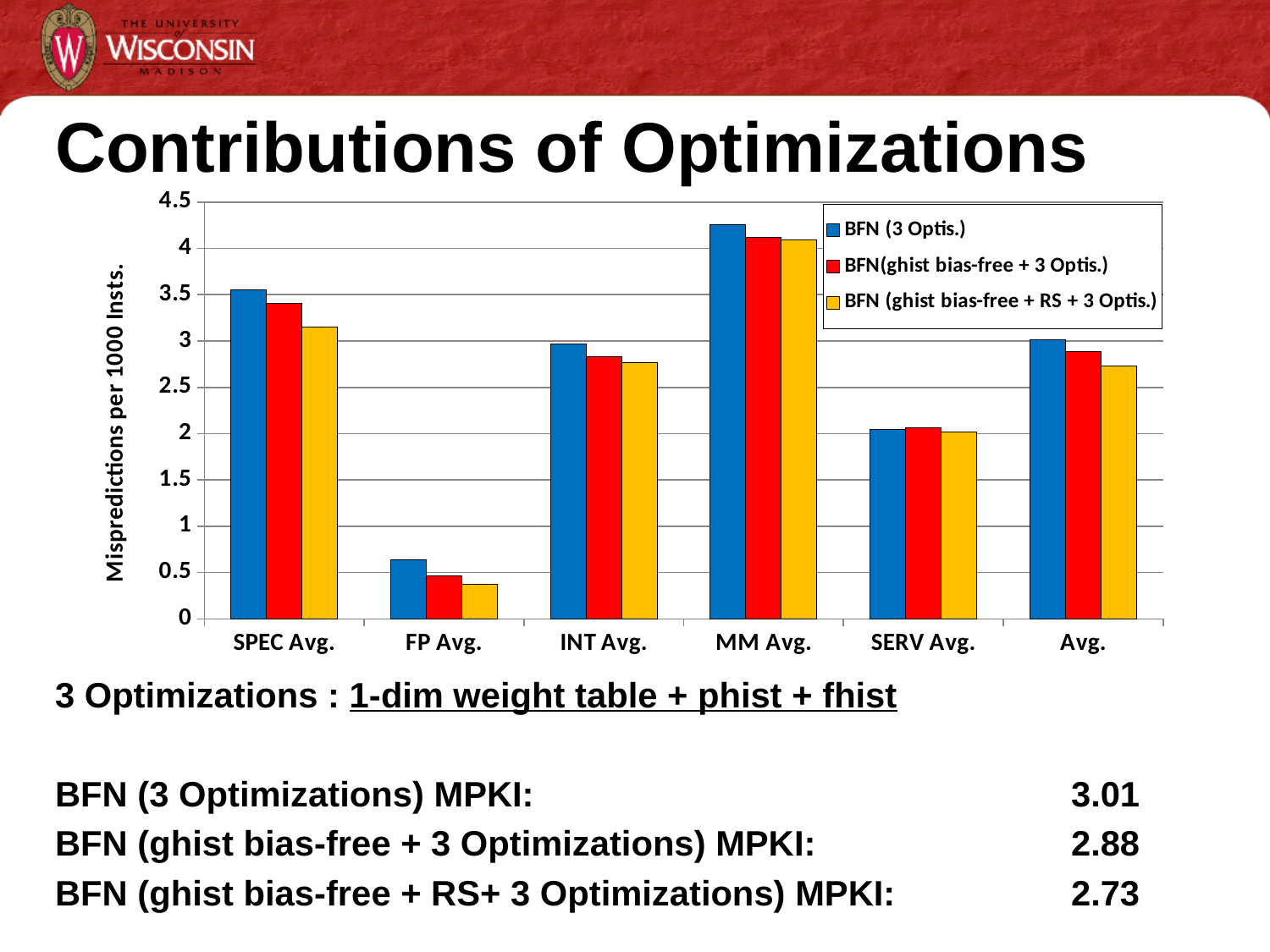
How many series does the chart's legend list? 3 According to the slide, what is the MPKI for BFN (ghist bias-free + RS + 3 Optimizations)? 2.73 For SPEC Avg., which series has the larger value: BFN (3 Optis.) or BFN (ghist bias-free + RS + 3 Optis.)? BFN (3 Optis.) Is the BFN (3 Optis.) value for MM Avg. greater or less than 4? greater What is the label on the y axis of the chart? Mispredictions per 1000 Insts. How many categories are shown along the x axis of the chart? 6 Which category has the lowest mispredictions per 1000 instructions across all three series? FP Avg. Is the BFN (3 Optis.) value for FP Avg. greater or less than 1? less What kind of chart is shown on the slide? bar chart Which category has the highest mispredictions per 1000 instructions for BFN (3 Optis.)? MM Avg. Is the BFN (ghist bias-free + RS + 3 Optis.) value for SPEC Avg. greater or less than 3.5? less According to the slide, what is the MPKI for BFN (3 Optimizations)? 3.01